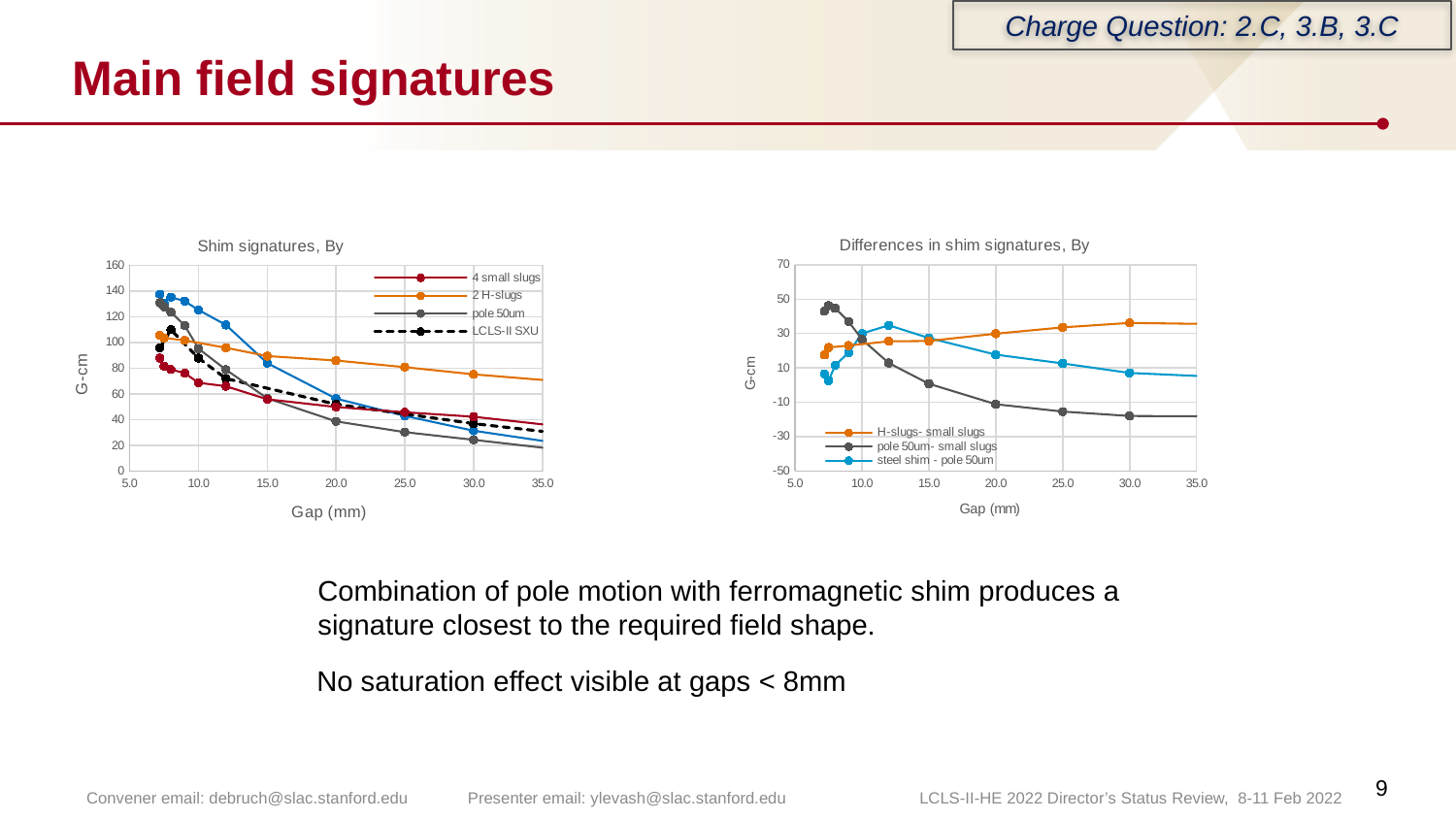
What kind of chart is the 'Shim signatures, By' chart? line chart How many series does the legend of the 'Differences in shim signatures, By' chart list? 3 What is the x-axis label of the 'Differences in shim signatures, By' chart? Gap (mm) In the 'Differences in shim signatures, By' chart, is the value for 'pole 50um- small slugs' at a gap of 30.0 mm greater or less than -10? less In the 'Shim signatures, By' chart, is the value for pole 50um at a gap of 30.0 mm greater or less than 40? less In the 'Differences in shim signatures, By' chart, does the 'pole 50um- small slugs' series rise or fall as the gap increases from 10.0 to 35.0 mm? fall In the 'Shim signatures, By' chart, which series has the lowest value at a gap of 35.0 mm? pole 50um In the 'Shim signatures, By' chart, at a gap of 30.0 mm, which is larger: 2 H-slugs or 4 small slugs? 2 H-slugs In the 'Shim signatures, By' chart, does the 4 small slugs series rise or fall as the gap increases? fall How many series does the legend of the 'Shim signatures, By' chart list? 4 In the 'Shim signatures, By' chart, is the value for 2 H-slugs at a gap of 10.0 mm greater or less than 80? greater In the 'Shim signatures, By' chart, which series has the highest value at a gap of 35.0 mm? 2 H-slugs